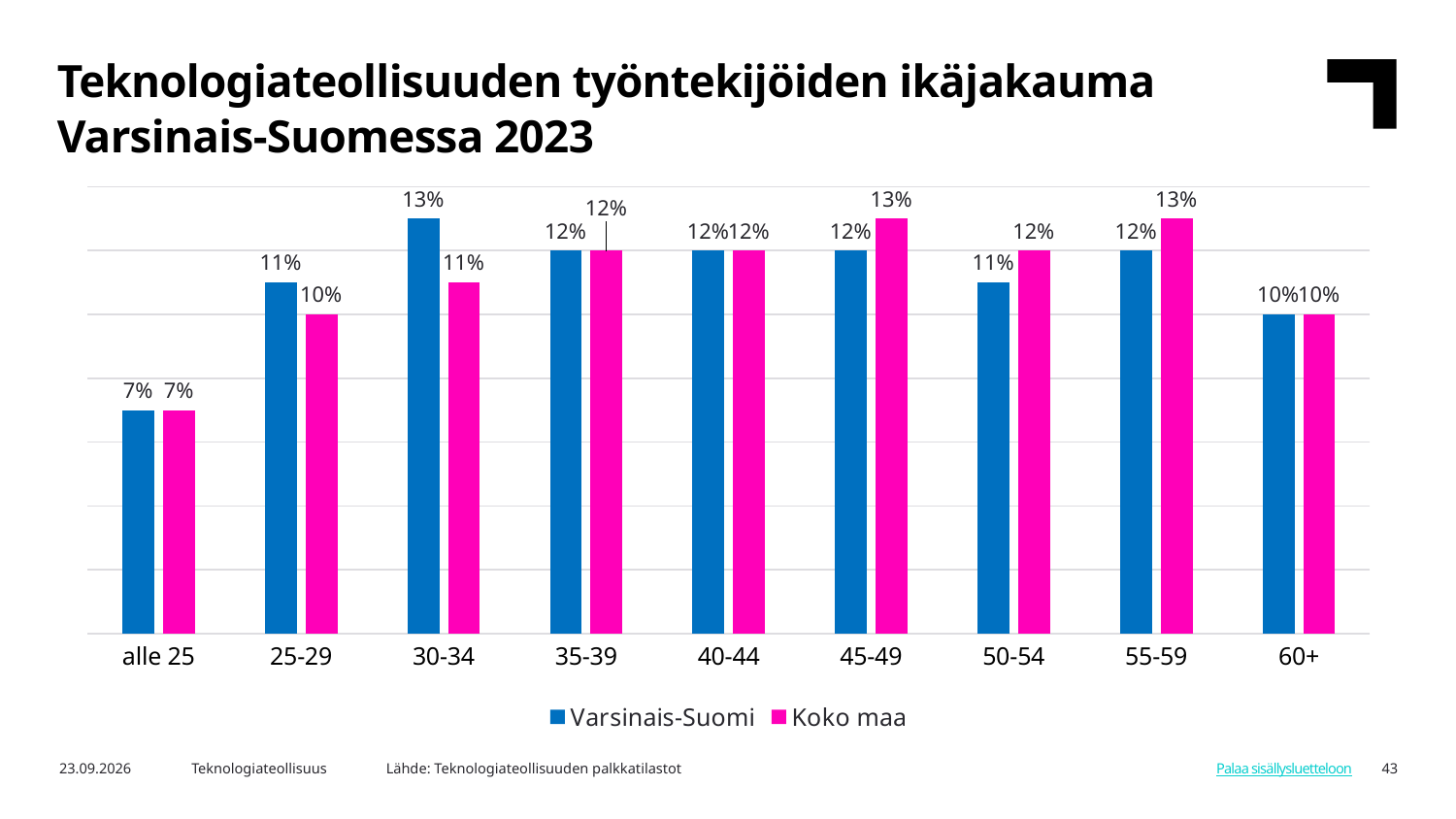
What is the difference between the Varsinais-Suomi and Koko maa values in the 30-34 age group? 2 percentage points What is the value for Koko maa in the 50-54 age group? 12% Which age group has the highest value for Varsinais-Suomi? 30-34 What is the value for Varsinais-Suomi in the 30-34 age group? 13% How many age groups are shown on the x axis? 9 How many series does the legend list? 2 Which series is shown in pink? Koko maa In the 25-29 age group, which series has the larger value, Varsinais-Suomi or Koko maa? Varsinais-Suomi In the 45-49 age group, which series has the larger value, Varsinais-Suomi or Koko maa? Koko maa What kind of chart is shown on the slide? Bar chart What is the value for Koko maa in the 25-29 age group? 10% Which age group has the lowest value for Koko maa? alle 25